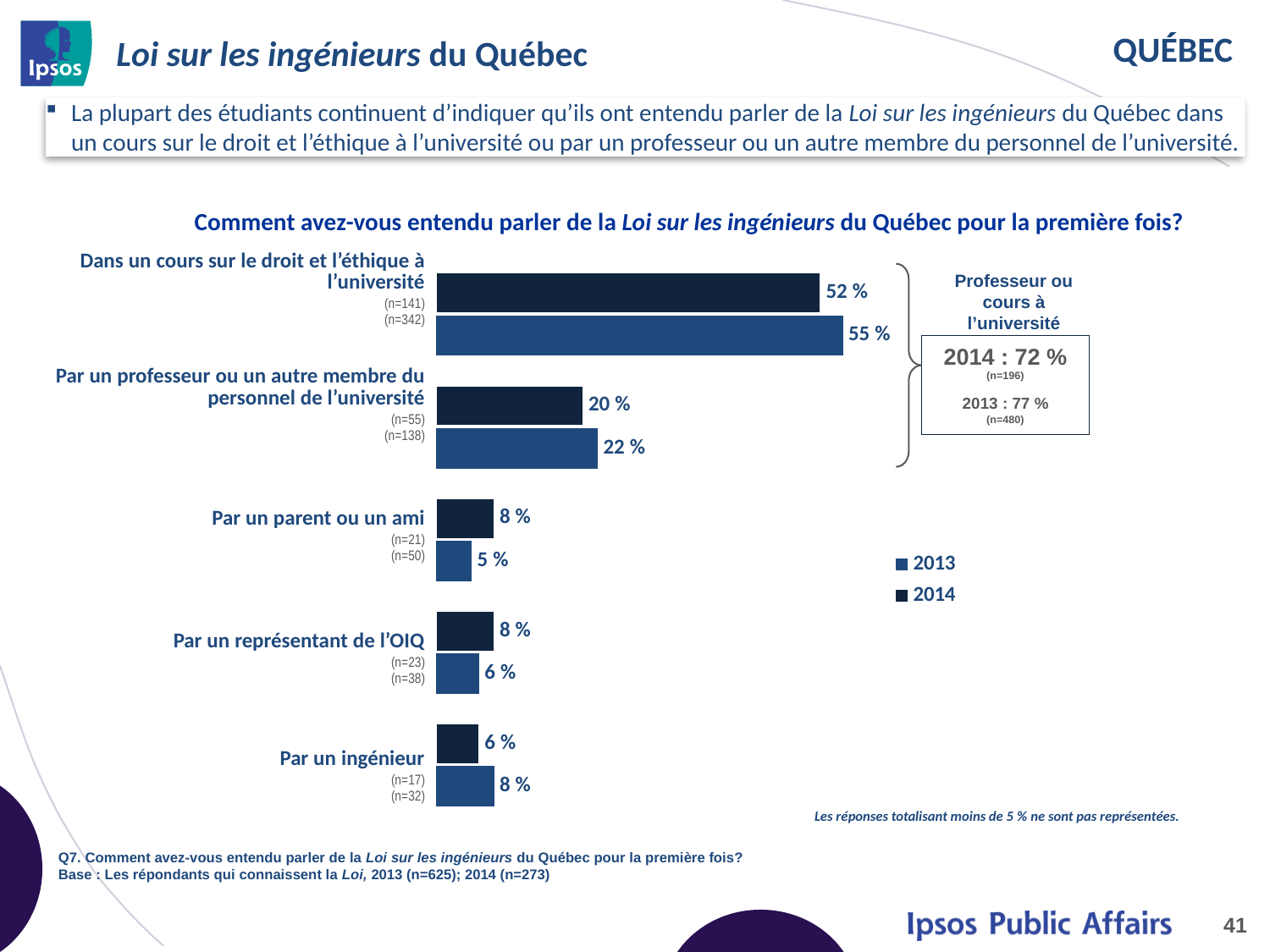
What is the value of the bottom bar for "Par un professeur ou un autre membre du personnel de l'université"? 22 % According to the callout box, what is the 2014 value for "Professeur ou cours à l'université"? 72 % Which response category has the highest values in the chart? Dans un cours sur le droit et l'éthique à l'université How many response categories are plotted in the chart? 5 For "Par un représentant de l'OIQ", which bar is larger, the top bar or the bottom bar? the top bar What is the value of the bottom bar for "Par un ingénieur"? 8 % What is the difference between the two bars for "Dans un cours sur le droit et l'éthique à l'université" (55 % and 52 %)? 3 % According to the callout box, what is the 2013 value for "Professeur ou cours à l'université"? 77 % How many series does the chart legend list? 2 What kind of chart is shown on the slide? bar chart What is the value of the top bar for "Par un parent ou un ami"? 8 % What are the two entries in the chart legend? 2013 and 2014